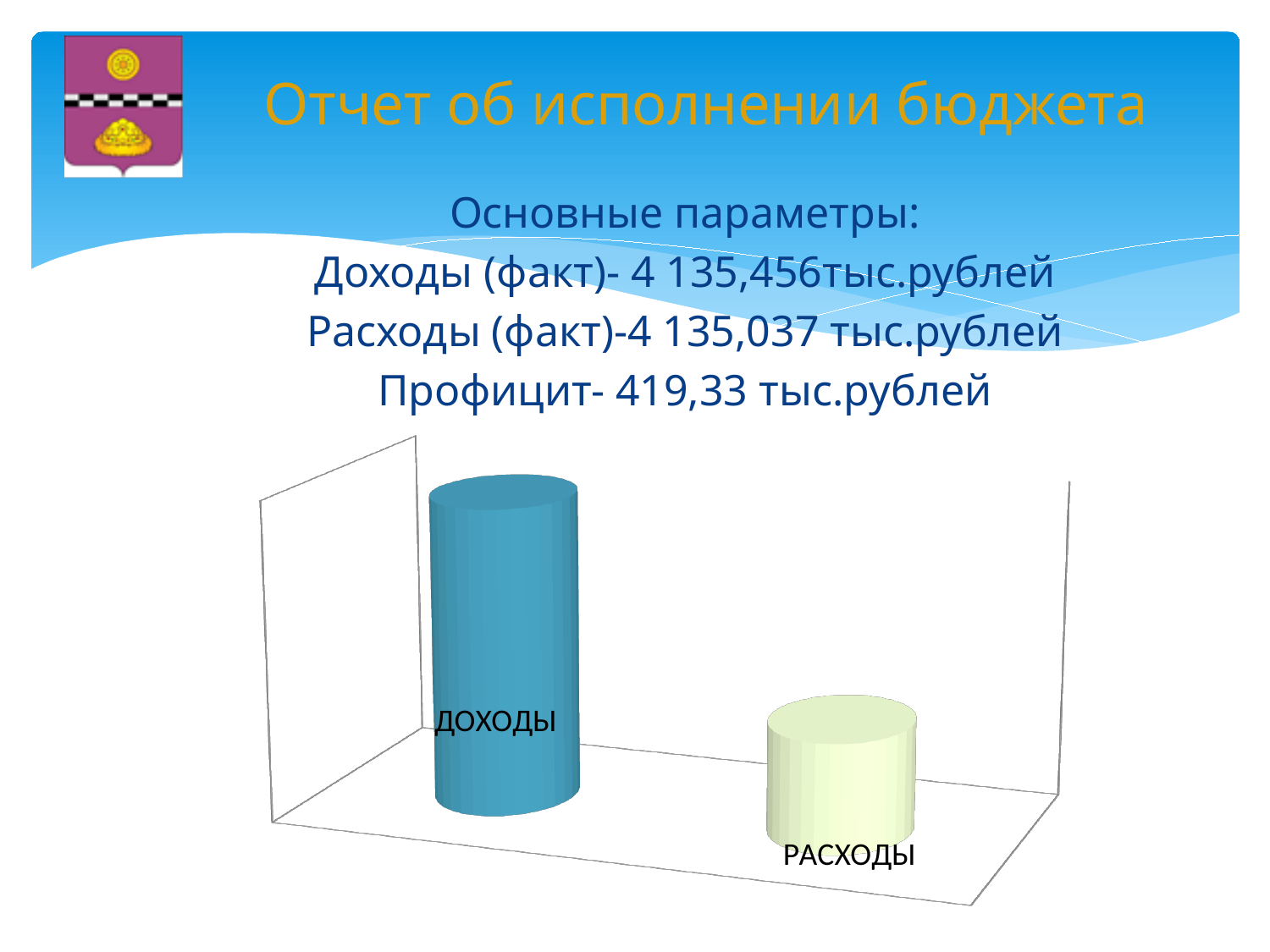
Which category has the shortest bar in the chart? РАСХОДЫ What kind of chart is shown on the slide? bar chart What colour is the ДОХОДЫ bar in the chart? blue How many bars are plotted in the chart? 2 Which bar is taller in the chart, ДОХОДЫ or РАСХОДЫ? ДОХОДЫ Do the bar heights rise or fall from left to right across the chart? fall What are the labels of the two bars in the chart, from left to right? ДОХОДЫ, РАСХОДЫ Which category has the tallest bar in the chart? ДОХОДЫ